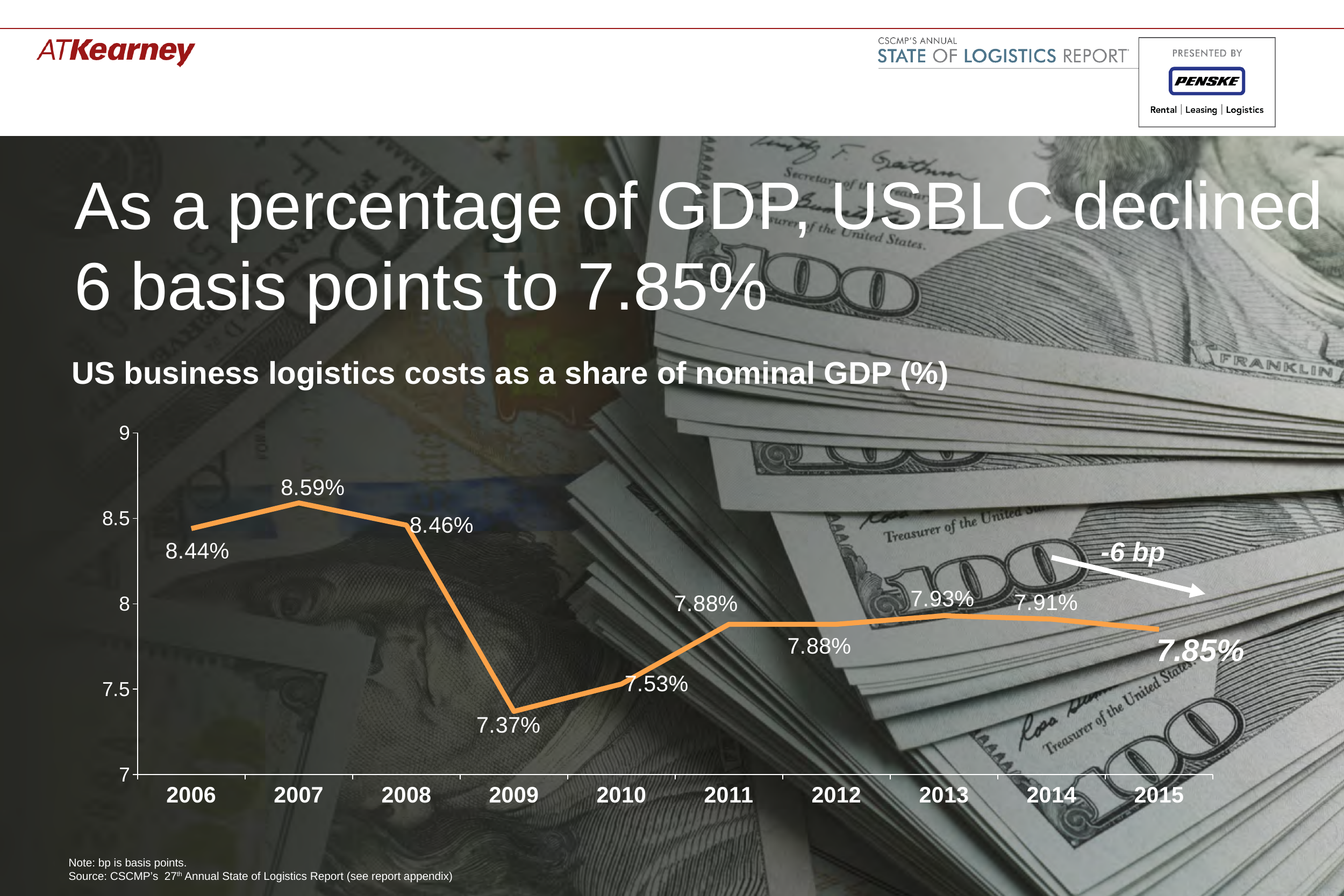
Which year has the lowest value? 2009 What was the value for 2013? 7.93% What was the value for 2007? 8.59% Which year has the highest value? 2007 Which is larger, the value for 2006 or the value for 2008? 2008 What is the title of the chart? US business logistics costs as a share of nominal GDP (%) What was the value for 2015? 7.85% What is the difference between the 2007 value and the 2009 value? 1.22 percentage points What kind of chart is shown? line chart Is the value for 2010 greater or less than 8? less How many years are plotted on the chart? 10 What was the value for 2009? 7.37%